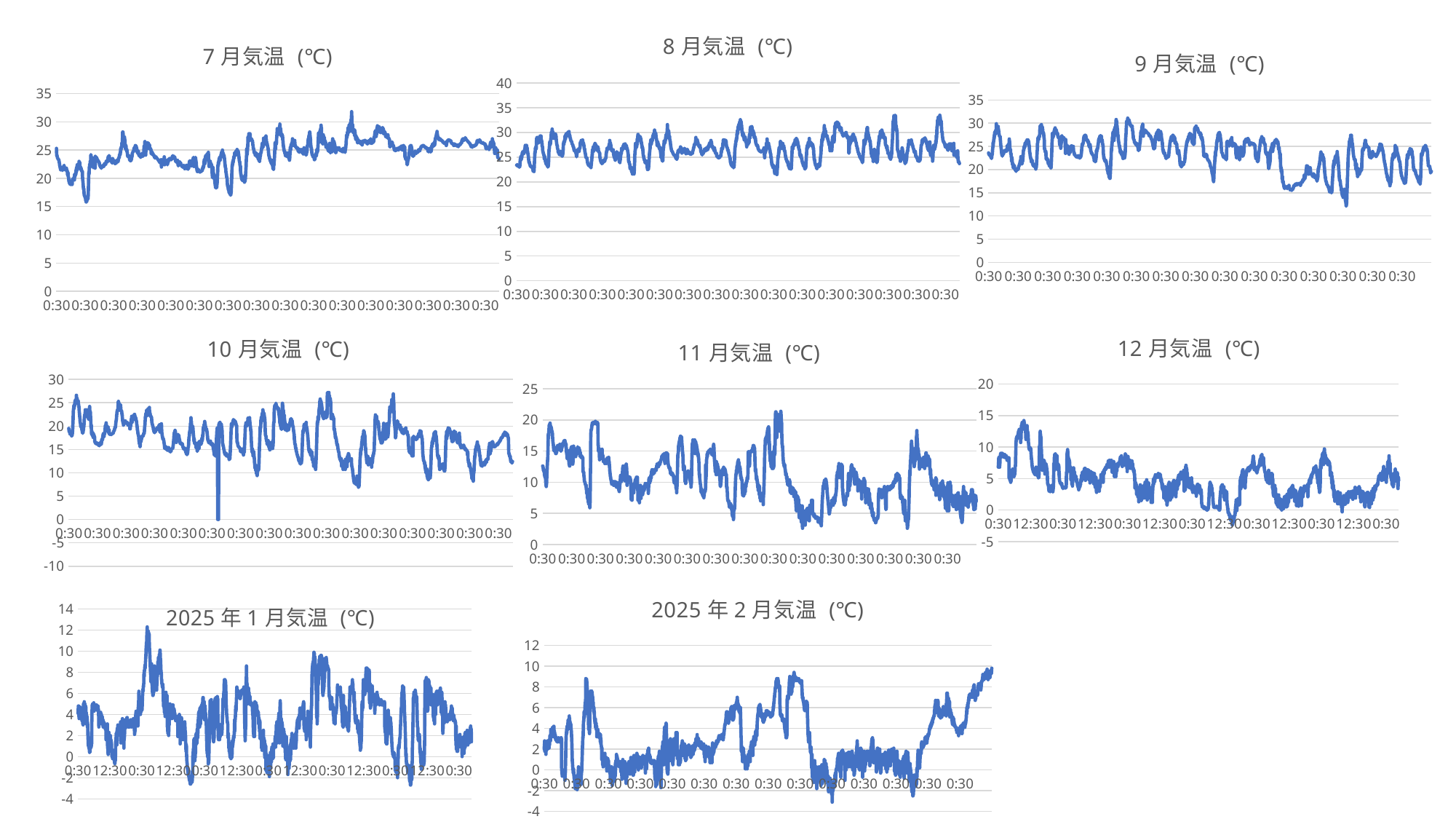
In the "9 月気温（℃）" chart, is the lowest plotted value greater or less than 15? less Which chart reaches a higher peak temperature, "8 月気温（℃）" or "12 月気温（℃）"? 8 月気温（℃） How many charts are on the slide? 8 In the "8 月気温（℃）" chart, what is the highest value shown on the vertical axis? 40 In the "8 月気温（℃）" chart, is the lowest plotted value greater or less than 15? greater In the "2025 年 2 月気温（℃）" chart, do the values at the right end of the x axis rise or fall compared with the start? rise In the "7 月気温（℃）" chart, is the highest plotted value greater or less than 35? less What kind of chart is the "7 月気温（℃）" chart? line chart In the "12 月気温（℃）" chart, what is the lowest value shown on the vertical axis? -5